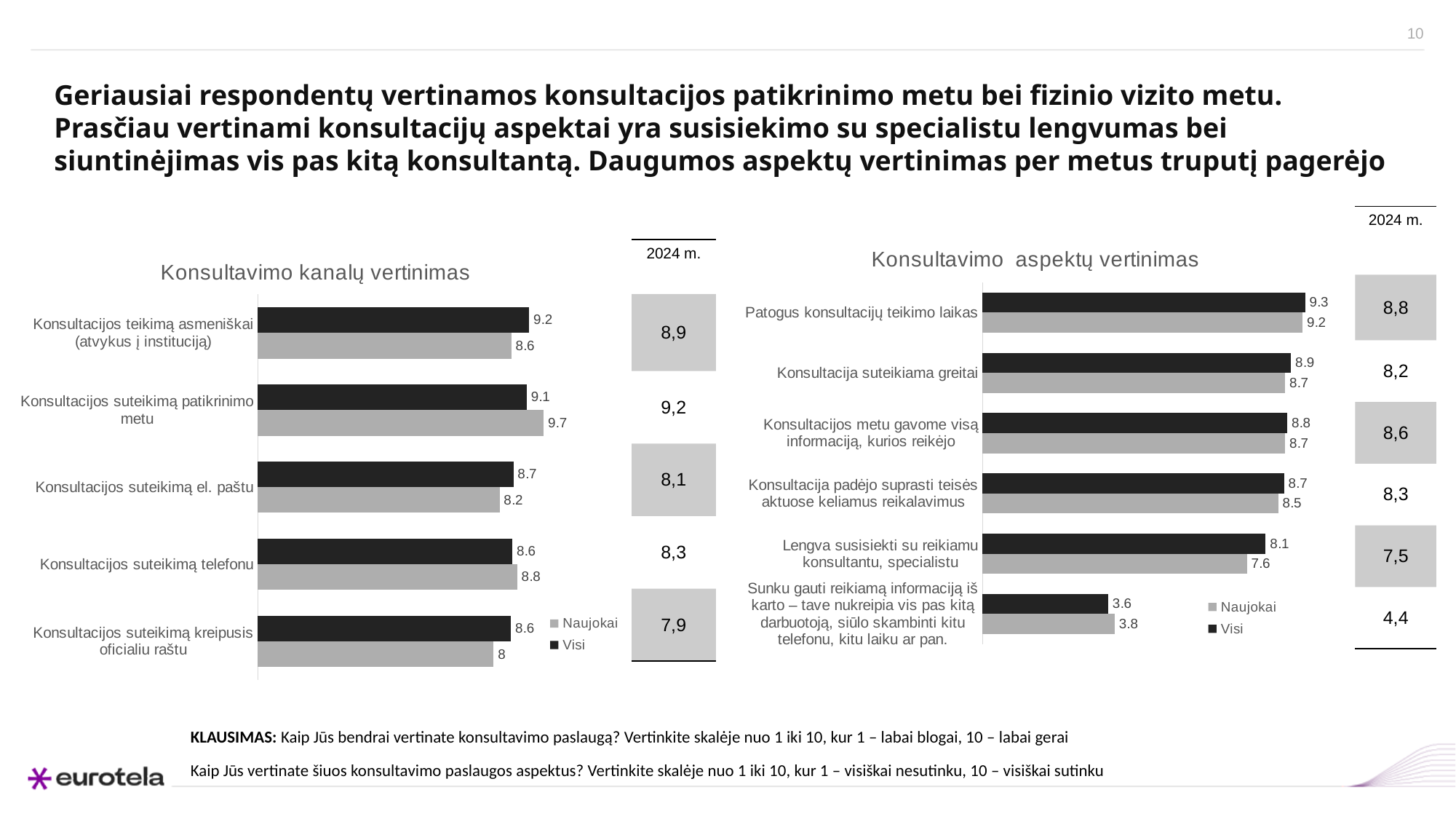
In the 'Konsultavimo kanalų vertinimas' chart, which colour represents the Naujokai series? Grey In the 'Konsultavimo kanalų vertinimas' chart, what is the difference between the Naujokai and Visi values for 'Konsultacijos suteikimą el. paštu'? 0.5 In the 'Konsultavimo aspektų vertinimas' chart, what is the Naujokai value for 'Lengva susisiekti su reikiamu konsultantu, specialistu'? 7.6 In the 'Konsultavimo kanalų vertinimas' chart, which category has the lowest Naujokai value? Konsultacijos suteikimą kreipusis oficialiu raštu In the 'Konsultavimo kanalų vertinimas' chart, what is the Visi value for 'Konsultacijos teikimą asmeniškai (atvykus į instituciją)'? 9.2 In the 'Konsultavimo kanalų vertinimas' chart, what is the Naujokai value for 'Konsultacijos suteikimą patikrinimo metu'? 9.7 What type of chart is 'Konsultavimo aspektų vertinimas'? Bar chart In the 'Konsultavimo aspektų vertinimas' chart, what is the Visi value for 'Patogus konsultacijų teikimo laikas'? 9.3 In the 'Konsultavimo aspektų vertinimas' chart, how many series does the legend list? 2 In the 'Konsultavimo aspektų vertinimas' chart, which is larger for 'Konsultacija suteikiama greitai': the Visi value or the Naujokai value? Visi In the 'Konsultavimo kanalų vertinimas' chart, how many categories are shown? 5 In the 'Konsultavimo aspektų vertinimas' chart, which category has the lowest Visi value? Sunku gauti reikiamą informaciją iš karto – tave nukreipia vis pas kitą darbuotoją, siūlo skambinti kitu telefonu, kitu laiku ar pan.